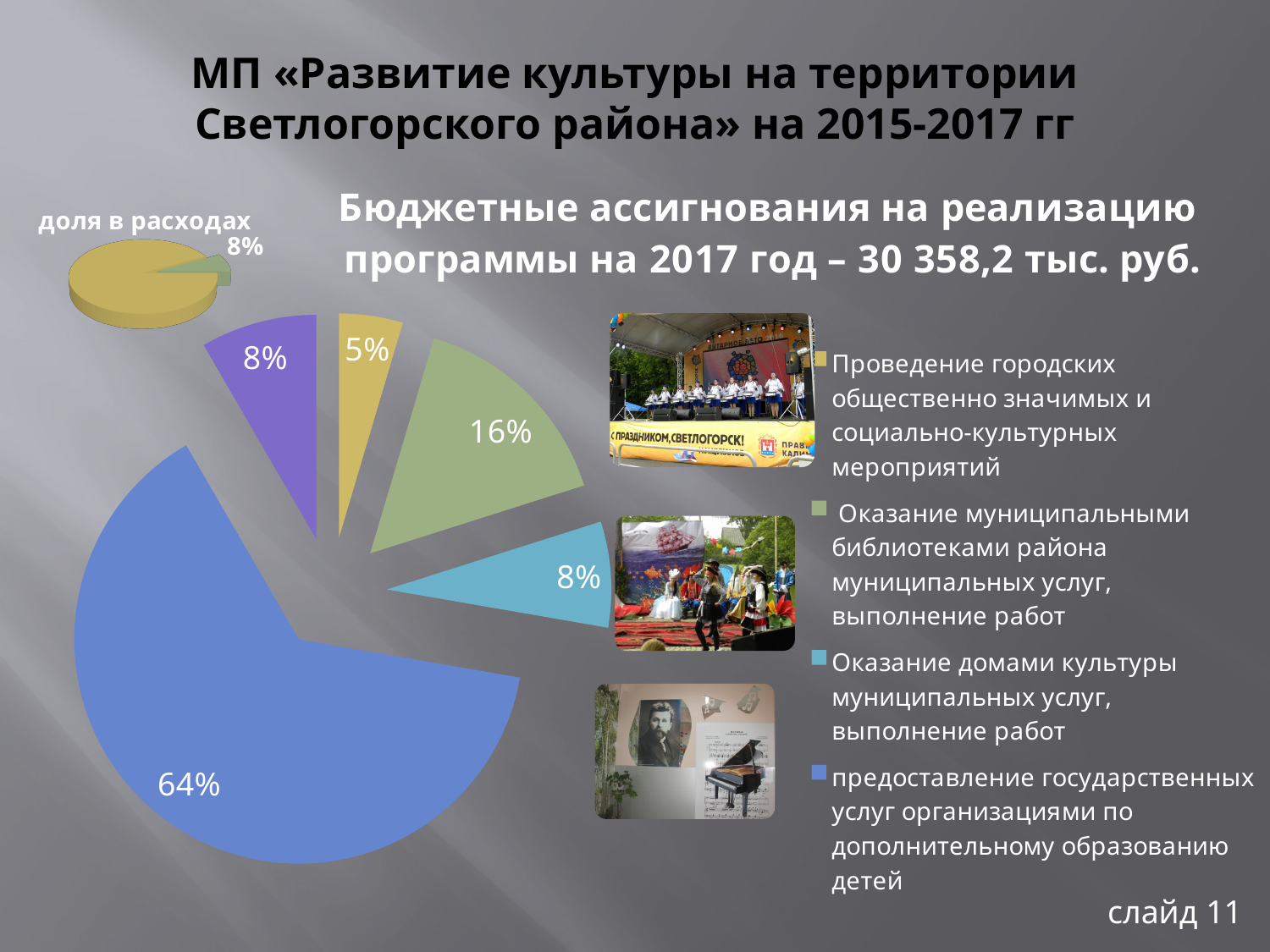
On the large pie chart, what percentage is shown for предоставление государственных услуг организациями по дополнительному образованию детей? 64% On the large pie chart, which is larger: the share for библиотеки or the share for дома культуры? библиотеки (16%) On the large pie chart, which category has the smallest share? Проведение городских общественно значимых и социально-культурных мероприятий (5%) On the large pie chart, which category has the largest share? предоставление государственных услуг организациями по дополнительному образованию детей (64%) On the large pie chart, what percentage is shown for Оказание муниципальными библиотеками района муниципальных услуг, выполнение работ? 16% How many entries does the legend of the large pie chart list? 4 What type of chart is the large chart on the left of the slide? Pie chart How many slices does the large pie chart have? 5 What is the title of the small pie chart in the top-left corner of the slide? доля в расходах On the large pie chart, what percentage is shown for Проведение городских общественно значимых и социально-культурных мероприятий? 5% On the large pie chart, what is the difference in percentage points between the share for дополнительное образование детей and the share for библиотеки? 48 percentage points On the large pie chart, what percentage is shown for Оказание домами культуры муниципальных услуг, выполнение работ? 8%